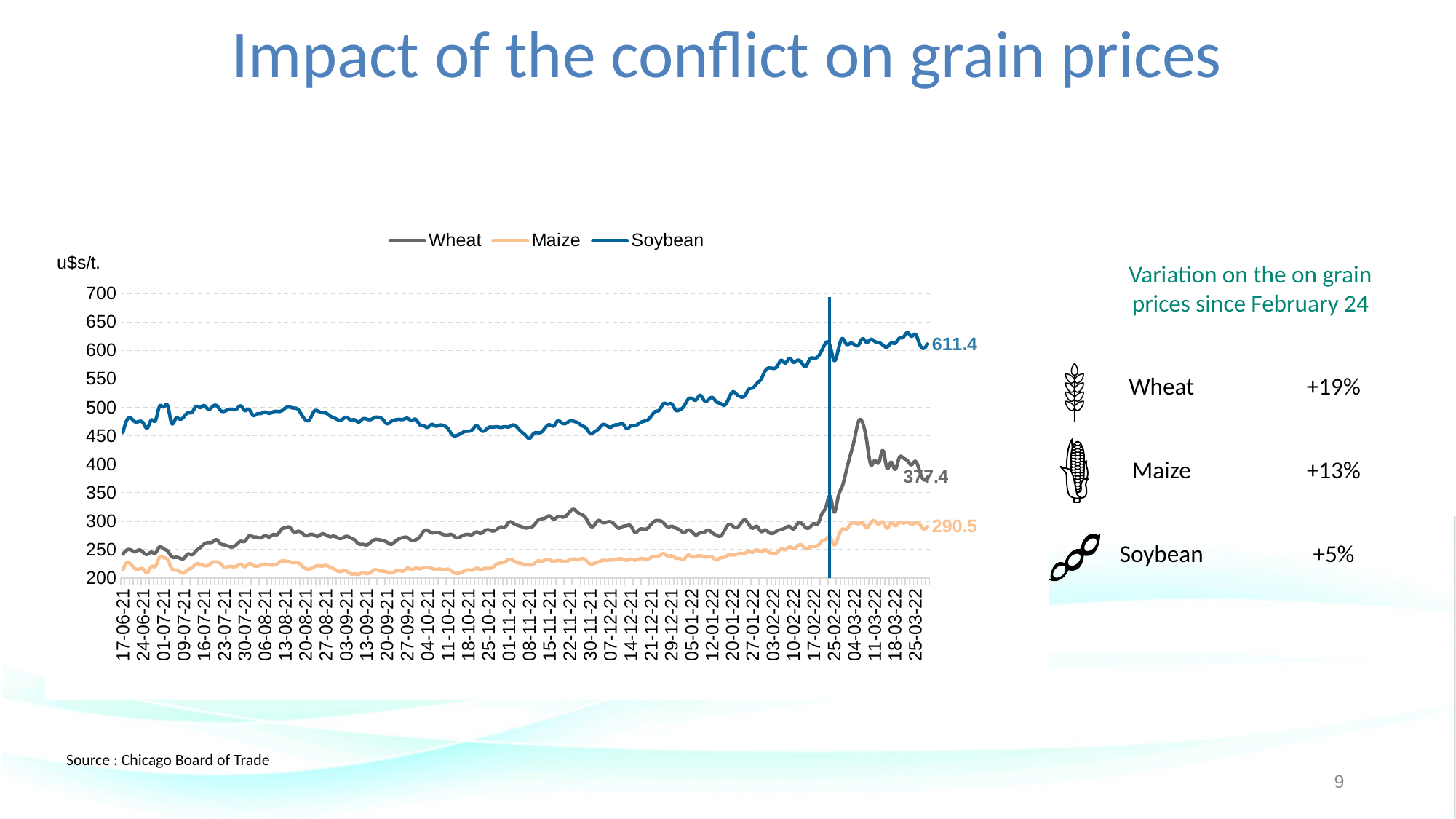
What is the final labelled value for Soybean on the chart? 611.4 What is the final labelled value for Maize on the chart? 290.5 Which series has the lowest prices across the whole chart? Maize Which series has the higher final labelled value, Soybean or Maize? Soybean What is the difference between the final labelled values for Soybean and Maize? 320.9 What kind of chart is shown on the slide? line chart Is the value for Wheat at its peak around 04-03-22 greater or less than 400? greater Does the Soybean price rise or fall from 17-06-21 to 25-03-22? rise Which series has the highest prices across the whole chart? Soybean How many series does the chart legend list? 3 What unit is shown on the chart's y axis? u$s/t. Is the value for Soybean at 17-06-21 greater or less than 500? less